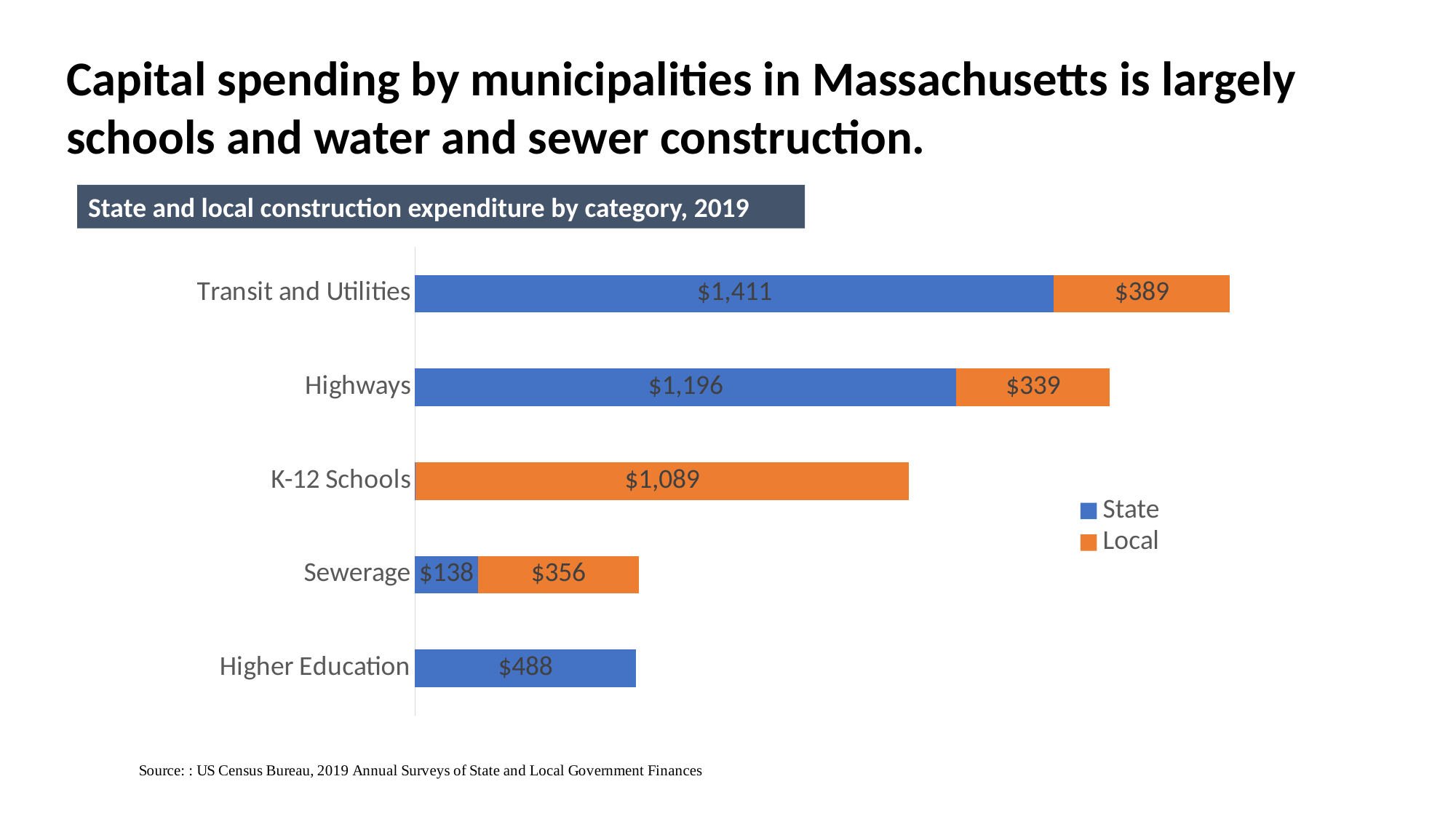
What is the difference between the State values for Transit and Utilities and Highways? $215 How many categories are shown on the chart? 5 What is the Local value for K-12 Schools? $1,089 What is the State value for Sewerage? $138 What is the Local value for Highways? $339 Which is larger for Sewerage, the State value or the Local value? Local Which category has the highest State value? Transit and Utilities What is the State value for Higher Education? $488 Which category has the lowest Local value among those with a Local label? Highways How many series does the legend list? 2 What is the State value for Transit and Utilities? $1,411 What is the total of the stacked bar for Highways? $1,535